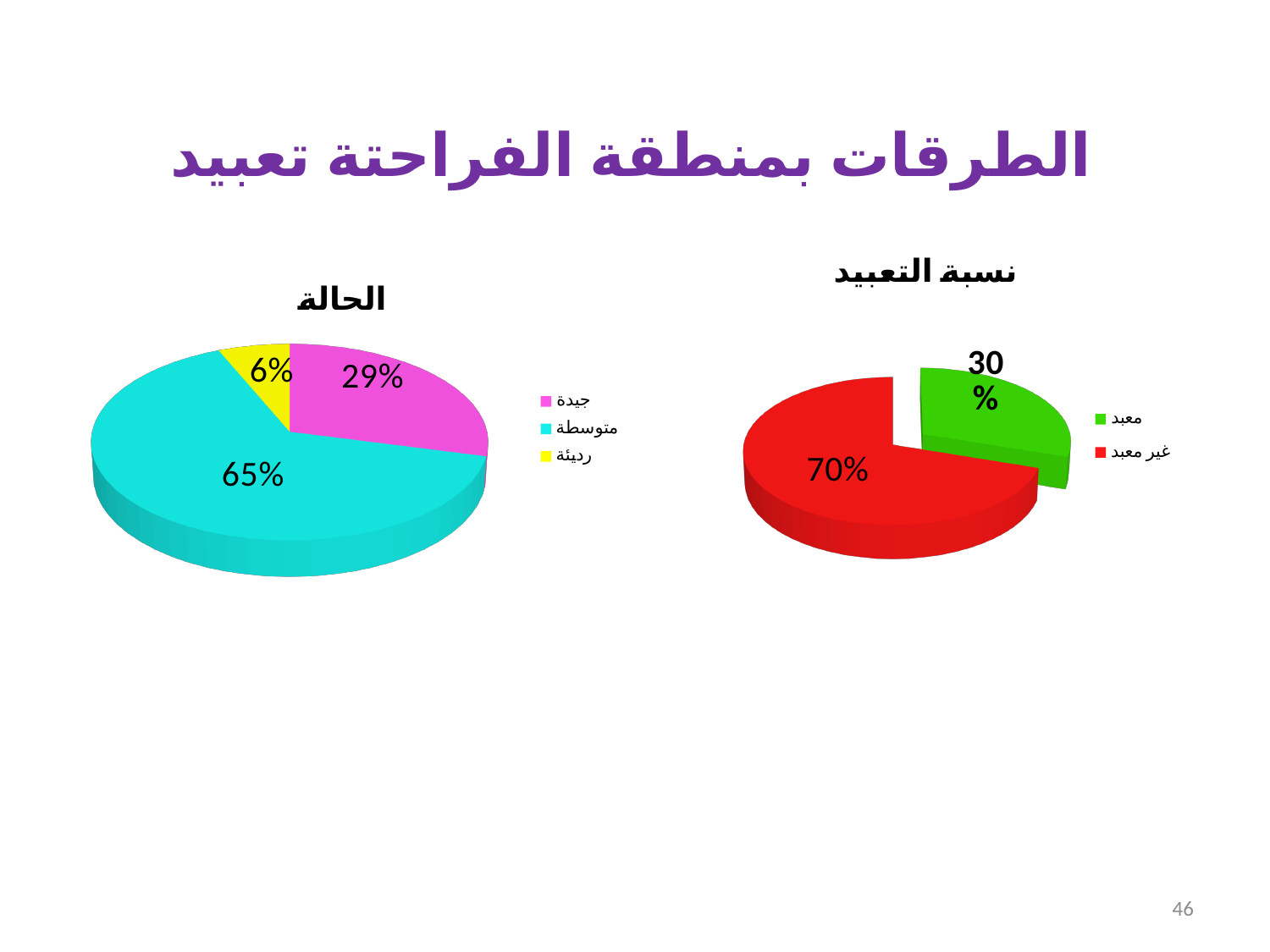
In the chart titled "نسبة التعبيد", what percentage is shown for "معبد"? 30% In the chart titled "نسبة التعبيد", what colour is the "غير معبد" slice? Red In the chart titled "الحالة", what percentage is shown for the "رديئة" slice? 6% In the chart titled "نسبة التعبيد", which is larger, "معبد" or "غير معبد"? غير معبد In the chart titled "نسبة التعبيد", what percentage is shown for "غير معبد"? 70% In the chart titled "الحالة", what percentage is shown for the "جيدة" slice? 29% In the chart titled "الحالة", which category has the smallest slice? رديئة What type of chart is the chart titled "نسبة التعبيد"? Pie chart In the chart titled "الحالة", how many slices does the pie have? 3 In the chart titled "الحالة", what is the difference between the "متوسطة" and "جيدة" percentages? 36% In the chart titled "الحالة", what percentage is shown for the "متوسطة" slice? 65% In the chart titled "الحالة", which category has the largest slice? متوسطة